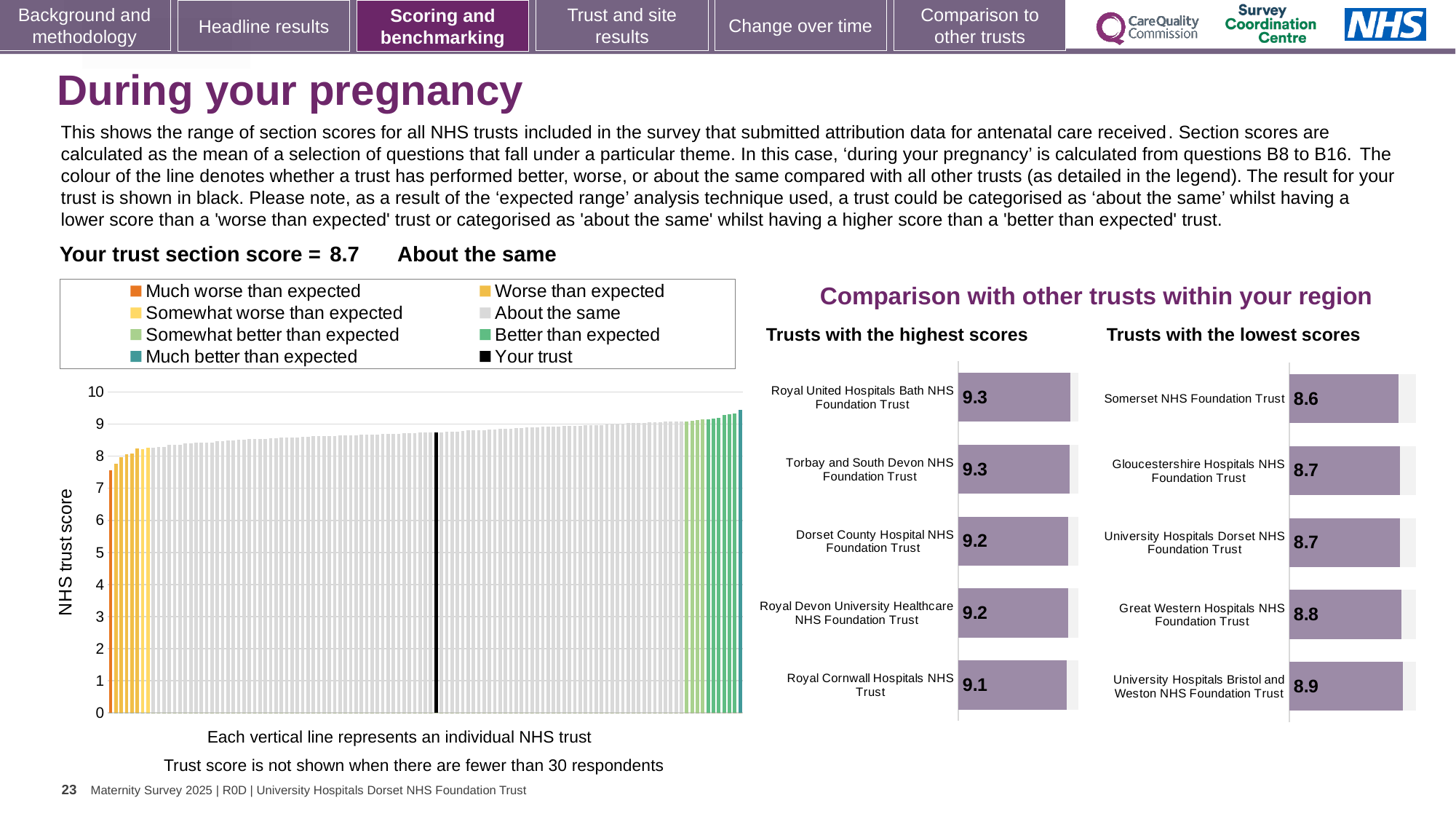
In the 'Trusts with the lowest scores' chart, what is the score for Somerset NHS Foundation Trust? 8.6 In the NHS trust score chart, do the bar values rise or fall from left to right? Rise In the 'Trusts with the highest scores' chart, what is the score for Royal Cornwall Hospitals NHS Trust? 9.1 How many trusts are listed in the 'Trusts with the highest scores' chart? 5 In the 'Trusts with the lowest scores' chart, which trust has the lowest score? Somerset NHS Foundation Trust What is the difference between the score for Royal United Hospitals Bath NHS Foundation Trust in the highest-scores chart and the score for Somerset NHS Foundation Trust in the lowest-scores chart? 0.7 How many entries does the legend of the NHS trust score chart list? 8 In the 'Trusts with the highest scores' chart, what is the score for Royal United Hospitals Bath NHS Foundation Trust? 9.3 In the 'Trusts with the lowest scores' chart, what is the score for University Hospitals Bristol and Weston NHS Foundation Trust? 8.9 In the 'Trusts with the highest scores' chart, which trust has the lowest score shown? Royal Cornwall Hospitals NHS Trust What kind of chart is the NHS trust score chart on the left of the slide? Bar chart In the 'Trusts with the lowest scores' chart, which has the larger score: Great Western Hospitals NHS Foundation Trust or Gloucestershire Hospitals NHS Foundation Trust? Great Western Hospitals NHS Foundation Trust